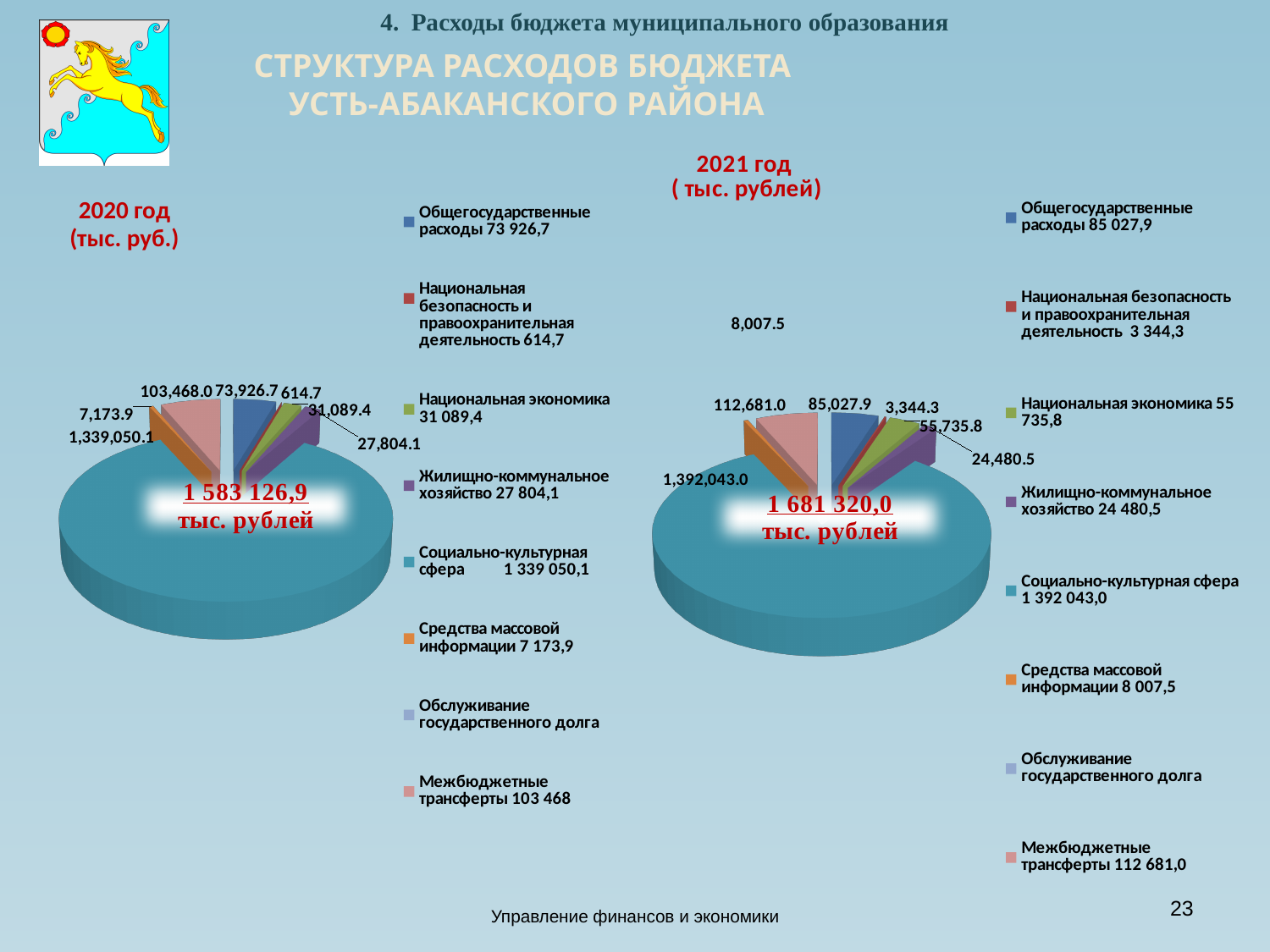
What type of chart is used for the 2020 год budget expenditure structure? pie chart What is the total shown in the centre of the 2021 год chart? 1 681 320,0 тыс. рублей Which is larger: Жилищно-коммунальное хозяйство on the 2020 год chart or on the 2021 год chart? 2020 год (27 804,1) What is the total shown in the centre of the 2020 год chart? 1 583 126,9 тыс. рублей On the 2021 год chart, what is the value for Национальная экономика? 55 735,8 On the 2020 год chart, what is the value for Общегосударственные расходы? 73 926,7 How many categories does the legend of the 2021 год chart list? 8 On the 2021 год chart, what is the difference between Межбюджетные трансферты and Общегосударственные расходы? 27 653,1 On the 2021 год chart, which category has the largest value? Социально-культурная сфера On the 2020 год chart, which legend entry has no value printed? Обслуживание государственного долга On the 2020 год chart, which category has the largest value? Социально-культурная сфера On the 2021 год chart, what is the value for Межбюджетные трансферты? 112 681,0